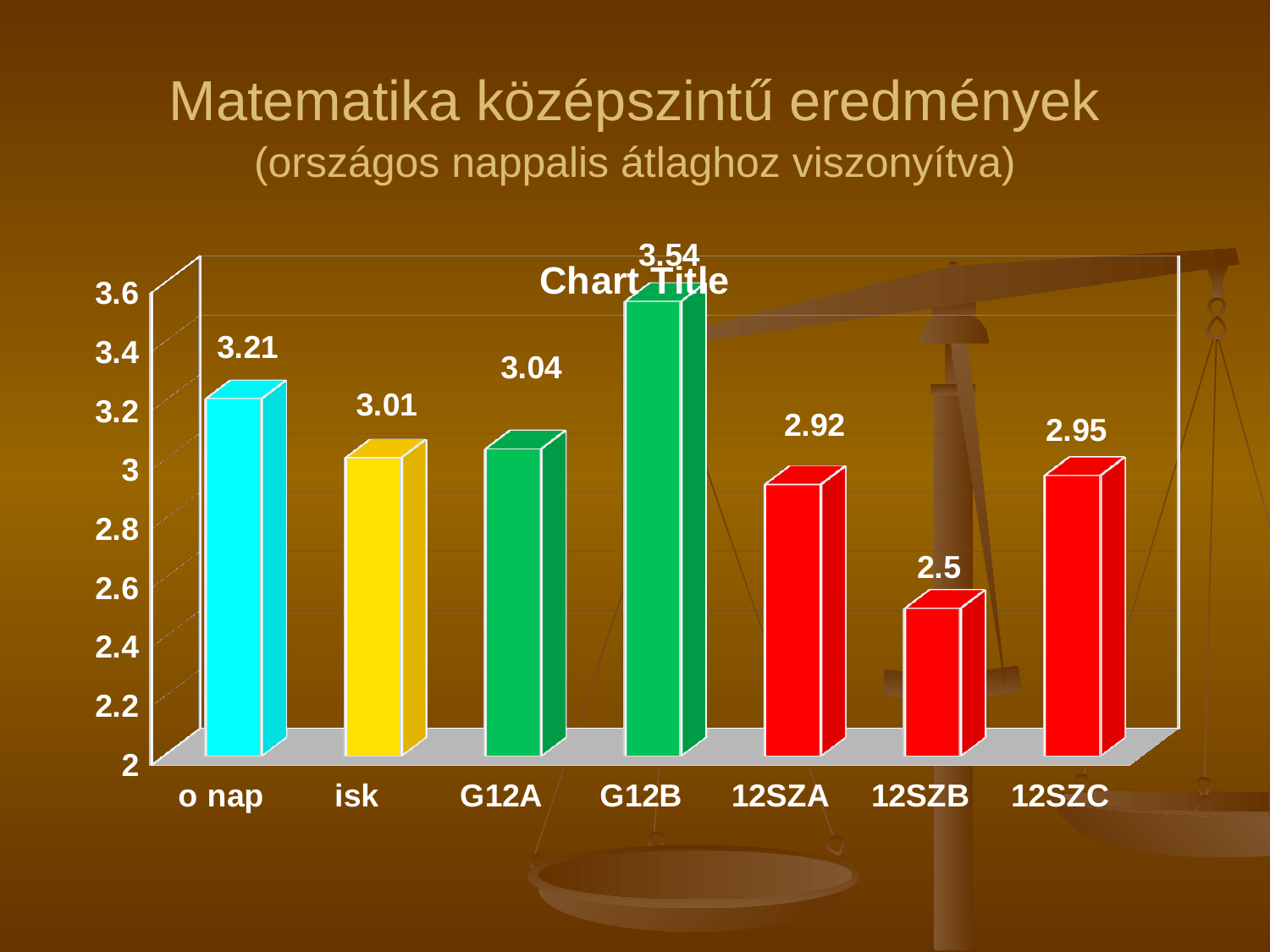
How many categories are shown on the x axis? 7 What is the value for 12SZC? 2.95 What is the value for G12B? 3.54 What is the difference between the values for o nap and isk? 0.2 What kind of chart is shown on the slide? bar chart Which is larger, the value for G12A or the value for 12SZA? G12A What is the value for o nap? 3.21 What is the difference between the values for G12B and 12SZB? 1.04 What is the value for 12SZB? 2.5 What is the title of the slide? Matematika középszintű eredmények (országos nappalis átlaghoz viszonyítva) Which category has the highest value? G12B Which category has the lowest value? 12SZB